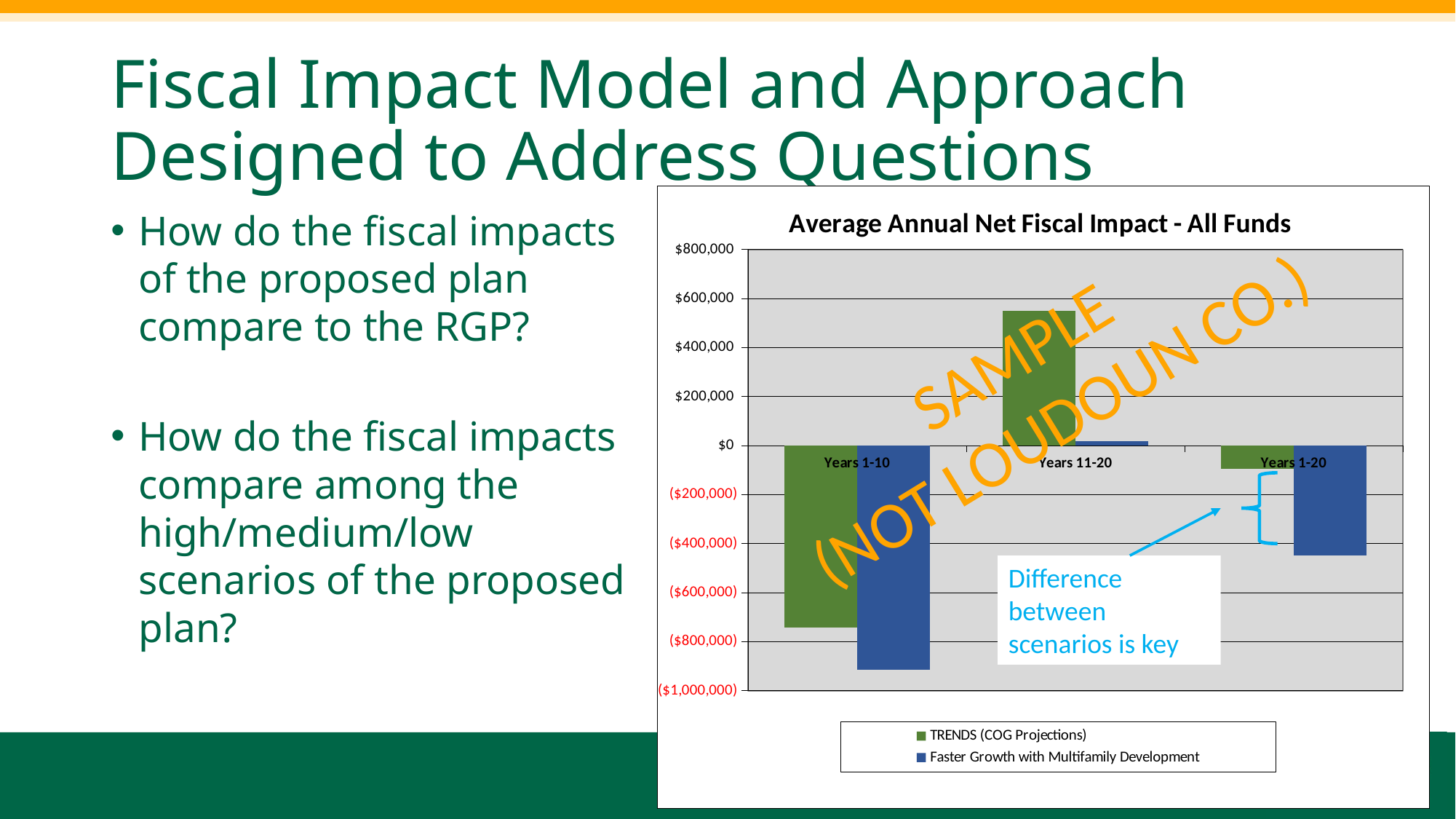
How many categories are shown on the x axis of the chart? 3 How many series does the chart's legend list? 2 In Years 1-10, which series has the higher value, TRENDS (COG Projections) or Faster Growth with Multifamily Development? TRENDS (COG Projections) Is the value for TRENDS (COG Projections) in Years 11-20 greater or less than $400,000? greater In Years 1-20, which series has the higher value, TRENDS (COG Projections) or Faster Growth with Multifamily Development? TRENDS (COG Projections) Which category and series has the highest value in the chart? TRENDS (COG Projections), Years 11-20 Is the value for Faster Growth with Multifamily Development in Years 1-10 greater or less than ($800,000)? less Which category and series has the lowest value in the chart? Faster Growth with Multifamily Development, Years 1-10 Which series is shown in green in the chart? TRENDS (COG Projections) What is the title of the chart? Average Annual Net Fiscal Impact - All Funds What kind of chart is shown on the slide? bar chart Is the value for TRENDS (COG Projections) in Years 1-10 greater or less than ($600,000)? less